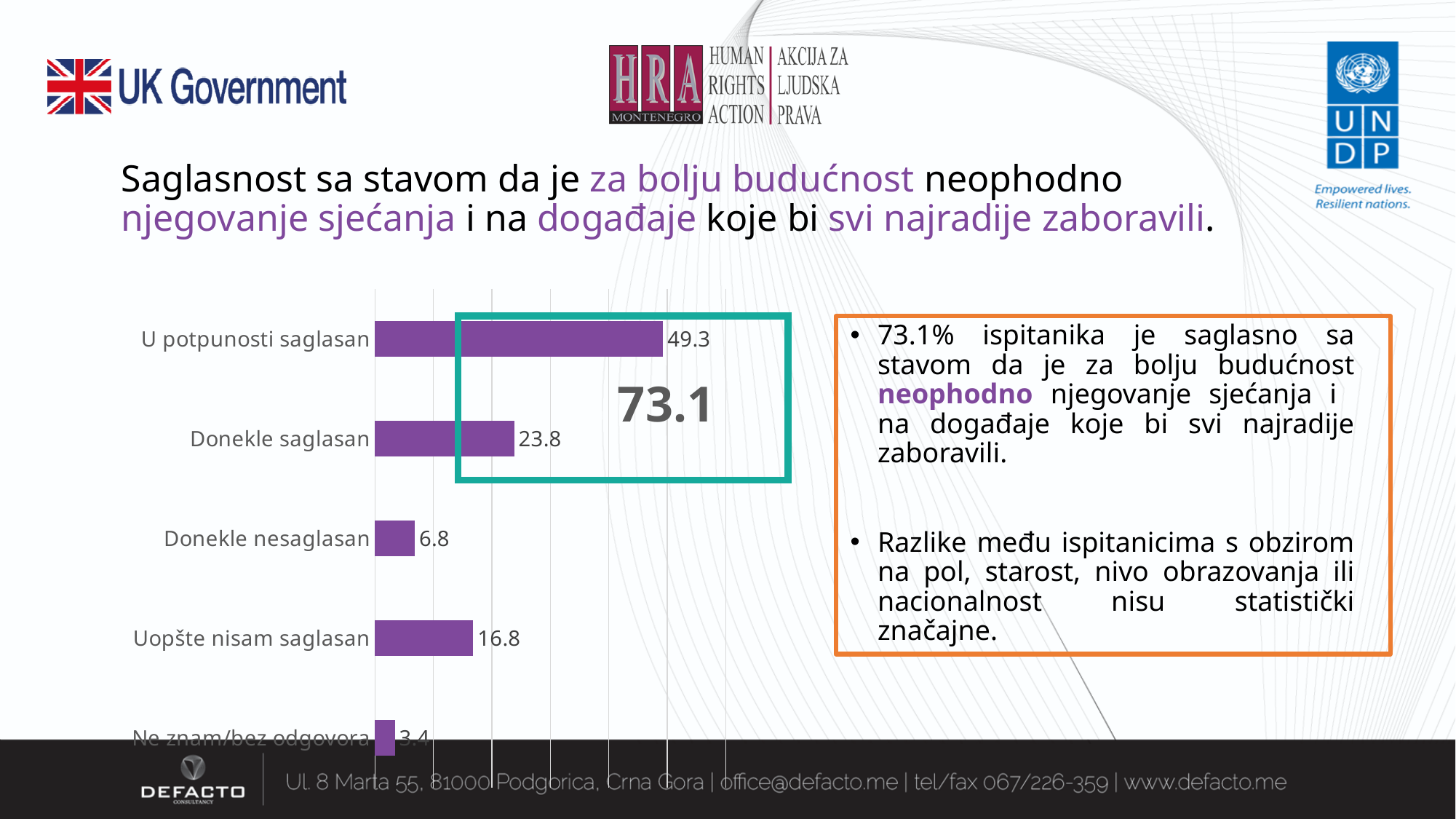
Which category has the lowest value? Ne znam/bez odgovora What is the difference between the values for "Uopšte nisam saglasan" and "Donekle nesaglasan"? 10 What is the difference between the values for "U potpunosti saglasan" and "Donekle saglasan"? 25.5 What is the value for "Uopšte nisam saglasan"? 16.8 What is the value for "Donekle nesaglasan"? 6.8 How many categories are shown in the chart? 5 Which category has the highest value? U potpunosti saglasan What is the value for "U potpunosti saglasan"? 49.3 What number is shown inside the green box highlighting the first two bars? 73.1 Which is larger, the value for "Donekle saglasan" or the value for "Uopšte nisam saglasan"? Donekle saglasan What is the value for "Donekle saglasan"? 23.8 What kind of chart is shown on the slide? Bar chart